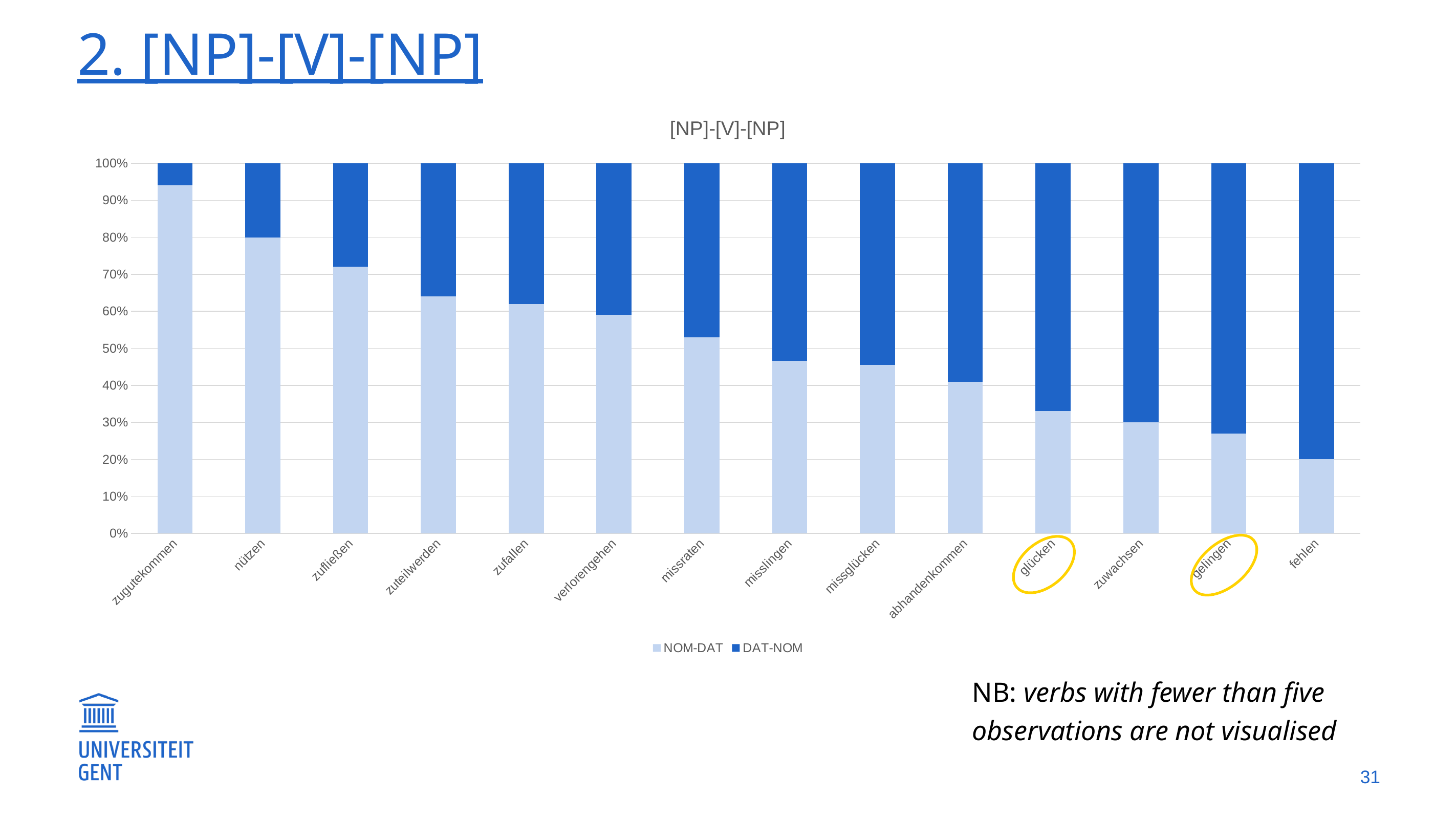
Does the NOM-DAT share rise or fall moving from left to right along the x axis? fall What kind of chart is shown on the slide? Stacked bar chart Which verb has the highest NOM-DAT share? zugutekommen Which verb has the lowest NOM-DAT share? fehlen How many series does the chart's legend list? 2 How many verbs (categories) are shown on the x axis of the chart? 14 Is the NOM-DAT share for zugutekommen greater or less than 90%? greater What are the two series named in the legend? NOM-DAT and DAT-NOM What is the NOM-DAT share for nützen? 80% What is the NOM-DAT share for fehlen? 20% Which verb has a larger NOM-DAT share, zufließen or missraten? zufließen Is the NOM-DAT share for misslingen greater or less than 50%? less